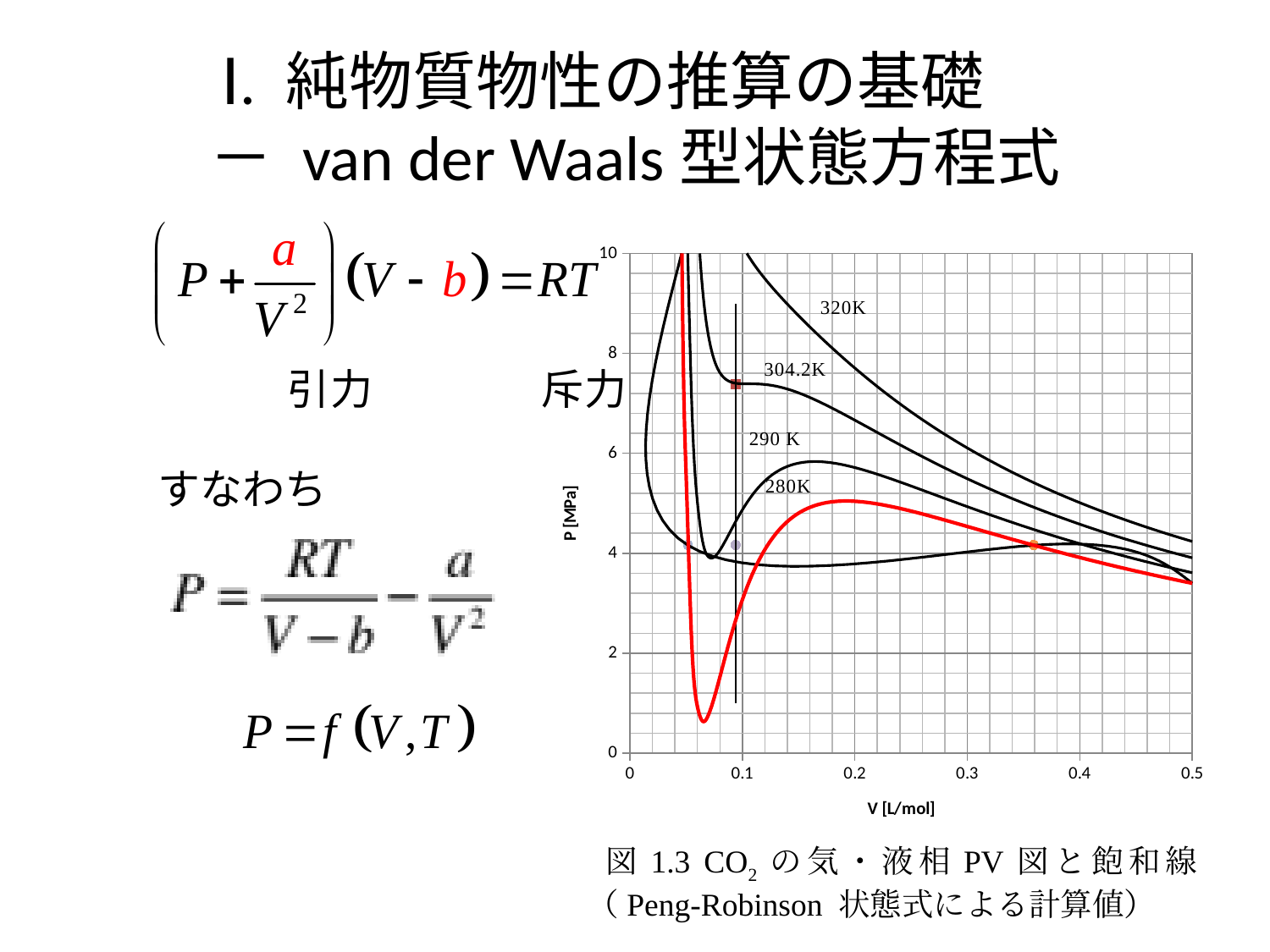
At V = 0.3 L/mol, which isotherm has the higher pressure, 320K or 280K? 320K What kind of chart is shown on the right of the slide? line chart Is the pressure at the marked point on the 304.2K isotherm greater or less than 6 MPa? greater Which labelled isotherm on the PV chart has the lowest temperature? 280K What is the label of the vertical axis of the PV chart? P [MPa] Is the lowest pressure reached by the red saturation curve greater or less than 2 MPa? less Along the 320K isotherm, does the pressure rise or fall as V increases from 0.1 to 0.5 L/mol? fall Which labelled isotherm on the PV chart has the highest temperature? 320K Is the peak pressure of the red saturation curve near V = 0.2 L/mol greater or less than 4 MPa? greater How many temperature-labelled isotherms are drawn on the PV chart? 4 What is the label of the horizontal axis of the PV chart? V [L/mol]